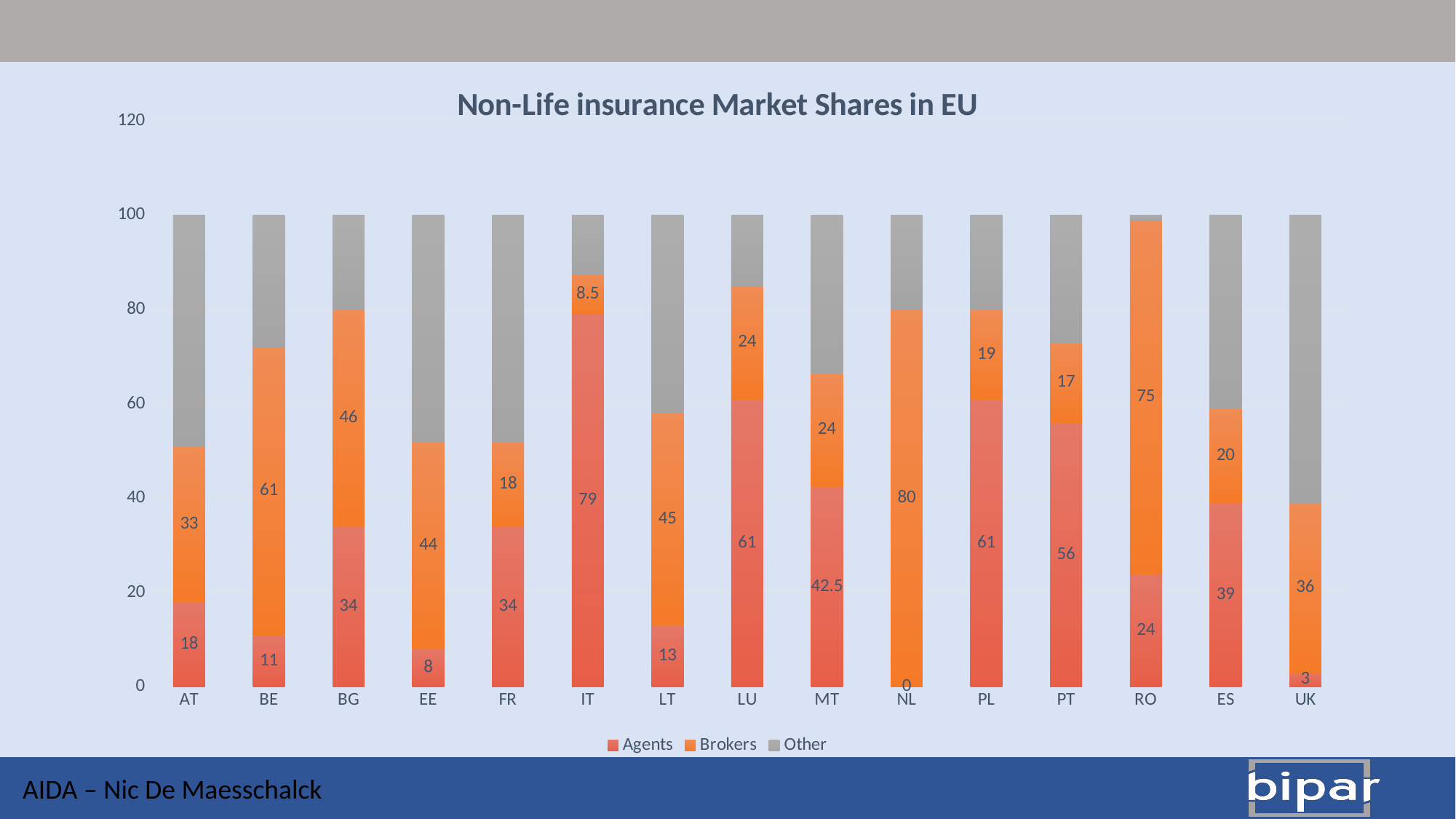
What is the Agents value for IT? 79 How many series does the legend list? 3 What is the title of the chart? Non-Life insurance Market Shares in EU What is the total of the stacked bar for AT? 100 Is the Other value for IT greater or less than 20? less What is the Brokers value for MT? 24 What is the difference between the Brokers and Agents values for BE? 50 What type of chart is shown on the slide? stacked bar chart Which country has the lowest Brokers value? IT How many countries are shown on the x axis? 15 For BG, which is larger: the Agents value or the Brokers value? Brokers Which country has the highest Agents value? IT